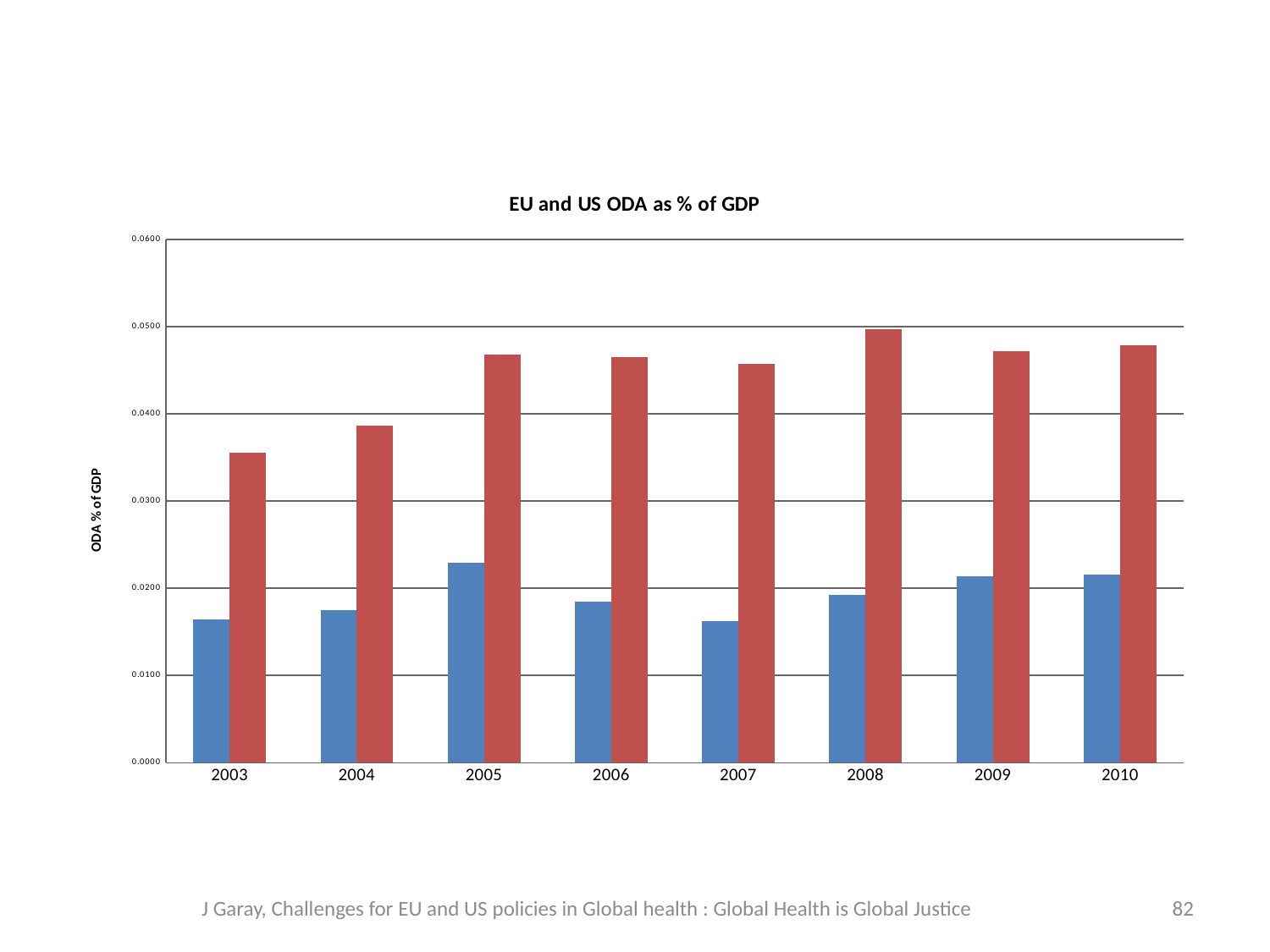
Is the value of the red bar for 2003 greater or less than 0.0400? less How many years are shown on the x axis of the chart? 8 In which year is the red bar the highest? 2008 In which year is the blue bar the highest? 2005 What is the title of the chart? EU and US ODA as % of GDP In which year is the red bar the lowest? 2003 Do the red bars rise or fall from 2003 to 2005? rise What is the label of the vertical axis? ODA % of GDP What kind of chart is shown on the slide? bar chart Is the value of the red bar for 2005 greater or less than 0.0400? greater In 2006, which bar is larger, the blue bar or the red bar? the red bar Is the value of the blue bar for 2005 greater or less than 0.0200? greater